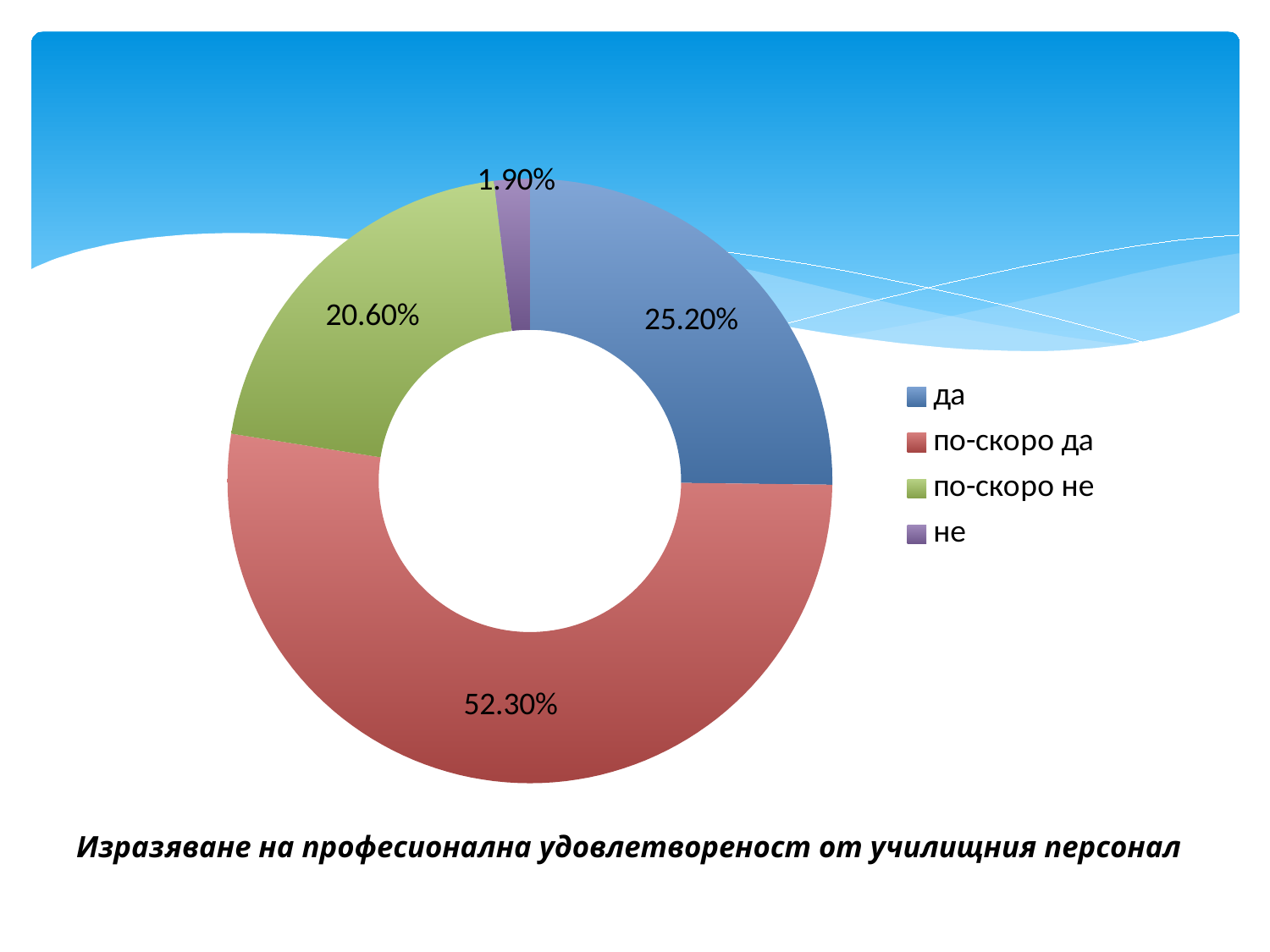
Which category has the smallest share of the chart? не What is the caption below the chart? Изразяване на професионална удовлетвореност от училищния персонал What colour is the "по-скоро не" slice? Green What is the difference in percentage points between "по-скоро да" and "да"? 27.10 What percentage is shown for the "по-скоро да" slice? 52.30% What percentage is shown for the "да" slice? 25.20% How many categories does the chart show? 4 Which category has the largest share of the chart? по-скоро да What percentage is shown for the "по-скоро не" slice? 20.60% What kind of chart is shown on the slide? Doughnut (pie) chart What percentage is shown for the "не" slice? 1.90% Which is larger, the share for "да" or the share for "по-скоро не"? да